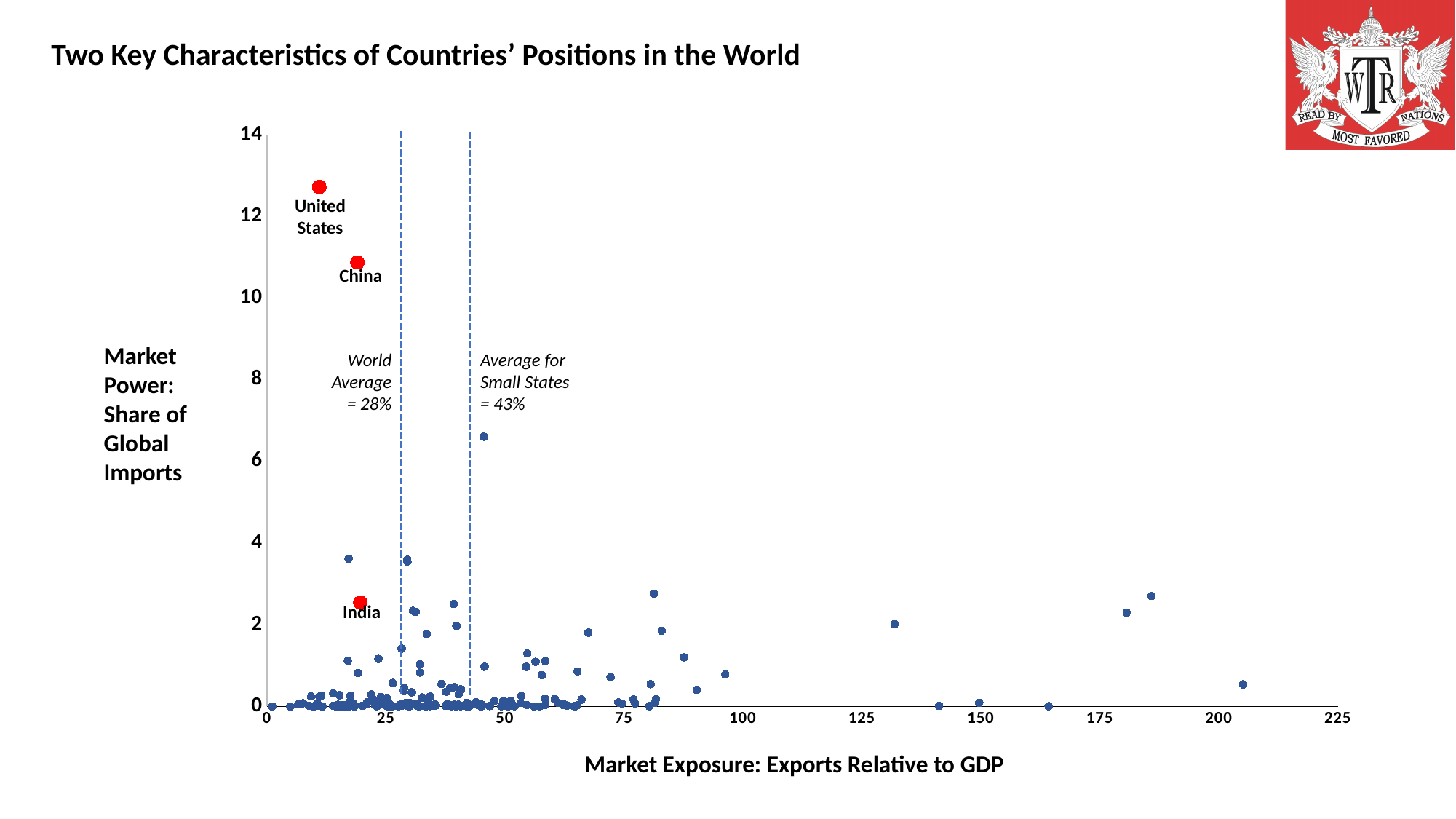
Is the share of global imports for the United States greater or less than 12? greater Which labelled country has the lowest share of global imports? India Is the share of global imports for China greater or less than 12? less What kind of chart is shown on the slide? scatter chart What is the title of the x axis? Market Exposure: Exports Relative to GDP Which has a larger share of global imports, the United States or China? United States Is the share of global imports for India greater or less than 4? less How many countries are labelled by name on the chart? 3 What value is given for the Average for Small States? 43% Which labelled country has the highest share of global imports? United States What value is given for the World Average of exports relative to GDP? 28%